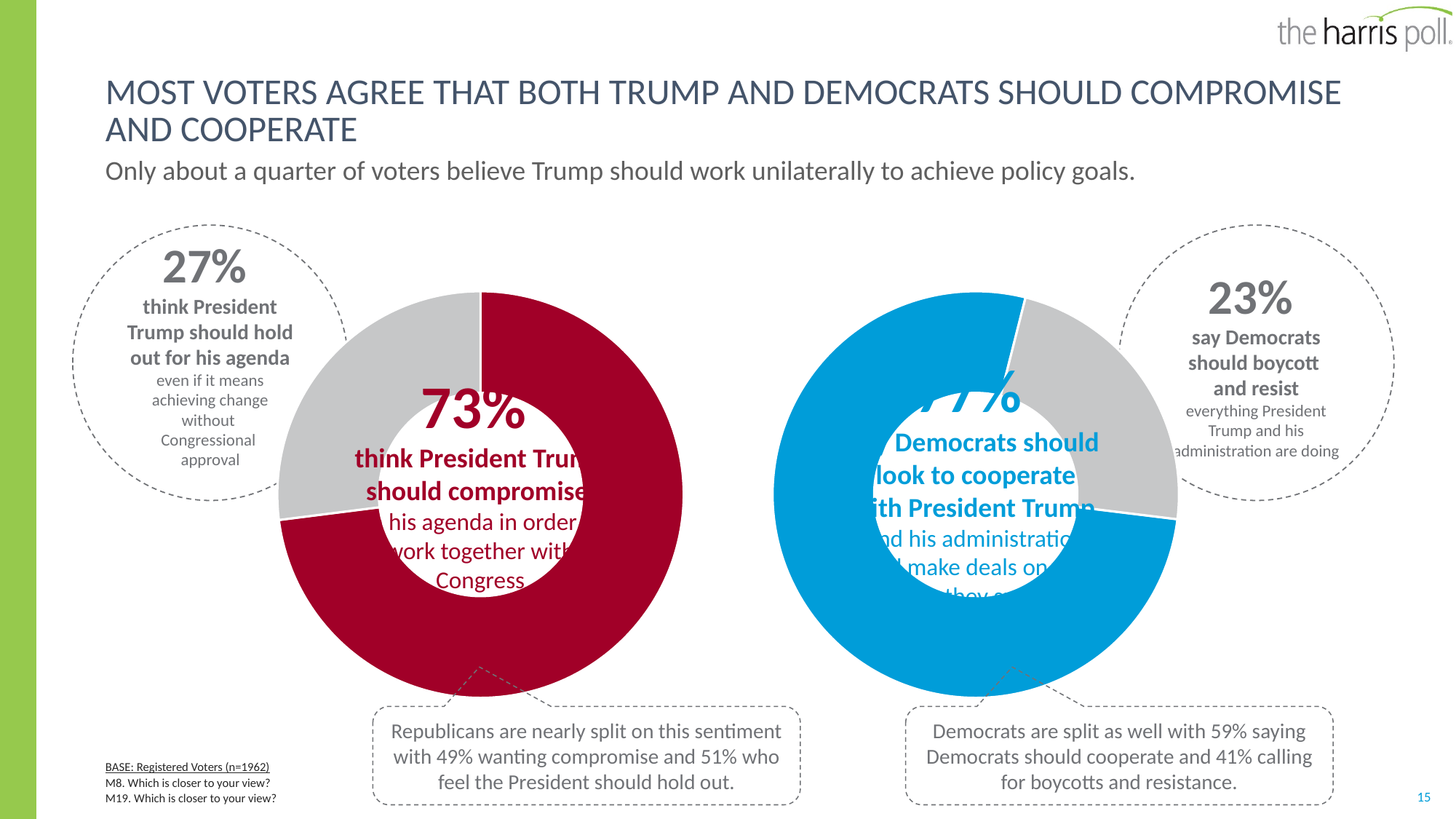
In the left donut chart, what is the difference in percentage points between those who think Trump should compromise and those who think he should hold out? 46 percentage points What kind of chart is used on the left side of the slide? Pie chart (donut) How many slices does the right donut chart have? 2 In the left donut chart, what percentage of voters think President Trump should compromise his agenda to work with Congress? 73% In the left donut chart, which is larger: the share who think Trump should compromise or the share who think he should hold out? Compromise What colour is the slice representing voters who think President Trump should compromise in the left donut chart? Red In the right donut chart, is the blue slice (Democrats should cooperate) greater or less than 50% of the chart? greater According to the callout under the left donut chart, what percentage of Republicans want compromise? 49% In the right donut chart, what percentage of voters say Democrats should boycott and resist everything President Trump and his administration are doing? 23% How many slices does the left donut chart have? 2 In the left donut chart, what percentage of voters think President Trump should hold out for his agenda? 27% In the right donut chart, is the grey slice (Democrats should boycott and resist) greater or less than 50% of the chart? less